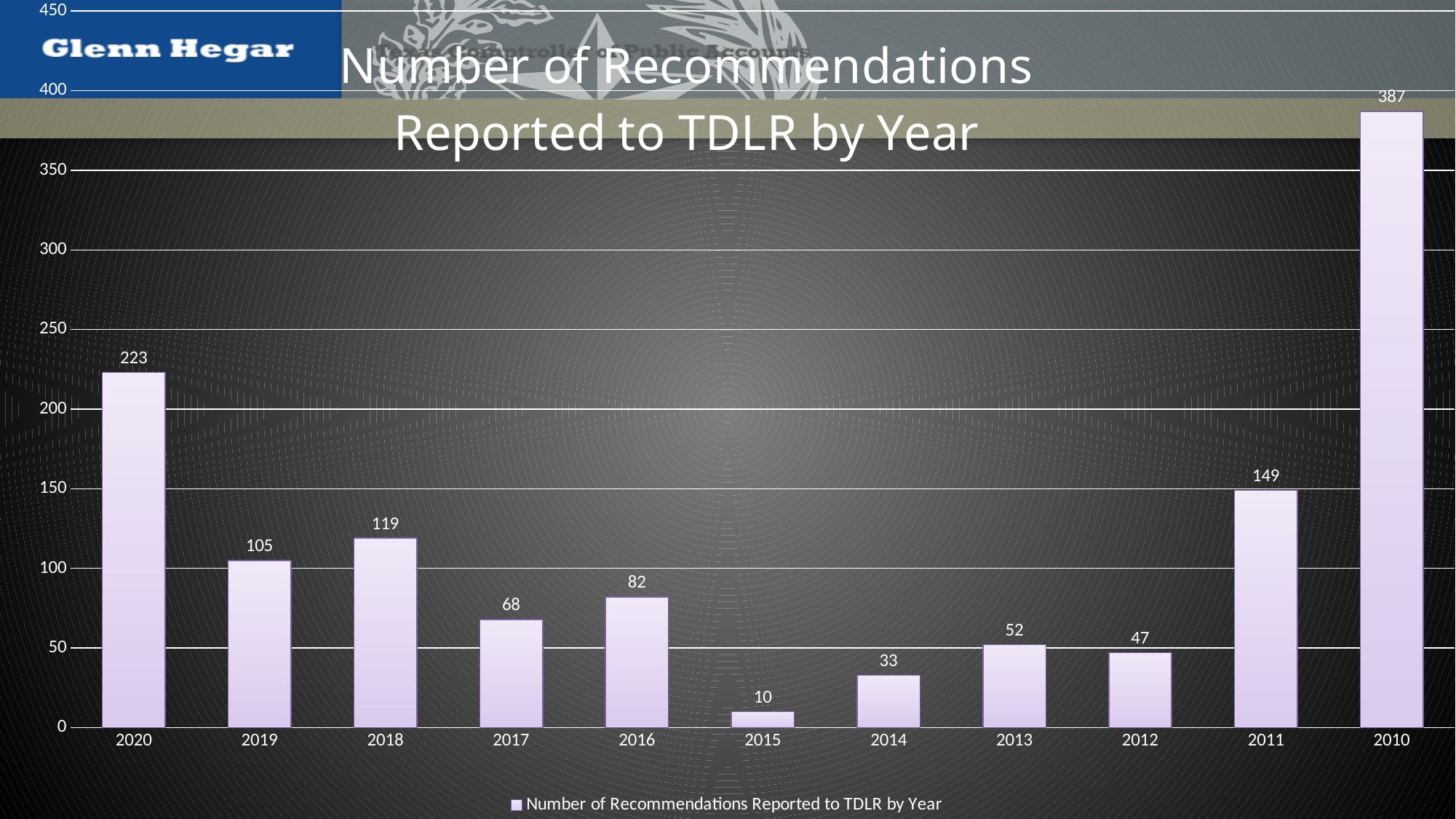
Is the value for 2016 greater or less than 100? less What is the number of recommendations reported to TDLR in 2011? 149 Which year has the highest number of recommendations reported to TDLR? 2010 Which year has the lowest number of recommendations reported to TDLR? 2015 Which year had more recommendations reported to TDLR, 2013 or 2012? 2013 What is the title of the chart? Number of Recommendations Reported to TDLR by Year What is the difference between the number of recommendations in 2010 and 2020? 164 What is the number of recommendations reported to TDLR in 2015? 10 What is the difference between the number of recommendations in 2018 and 2019? 14 What is the number of recommendations reported to TDLR in 2020? 223 What kind of chart is shown on the slide? bar chart How many years are shown on the x axis of the chart? 11